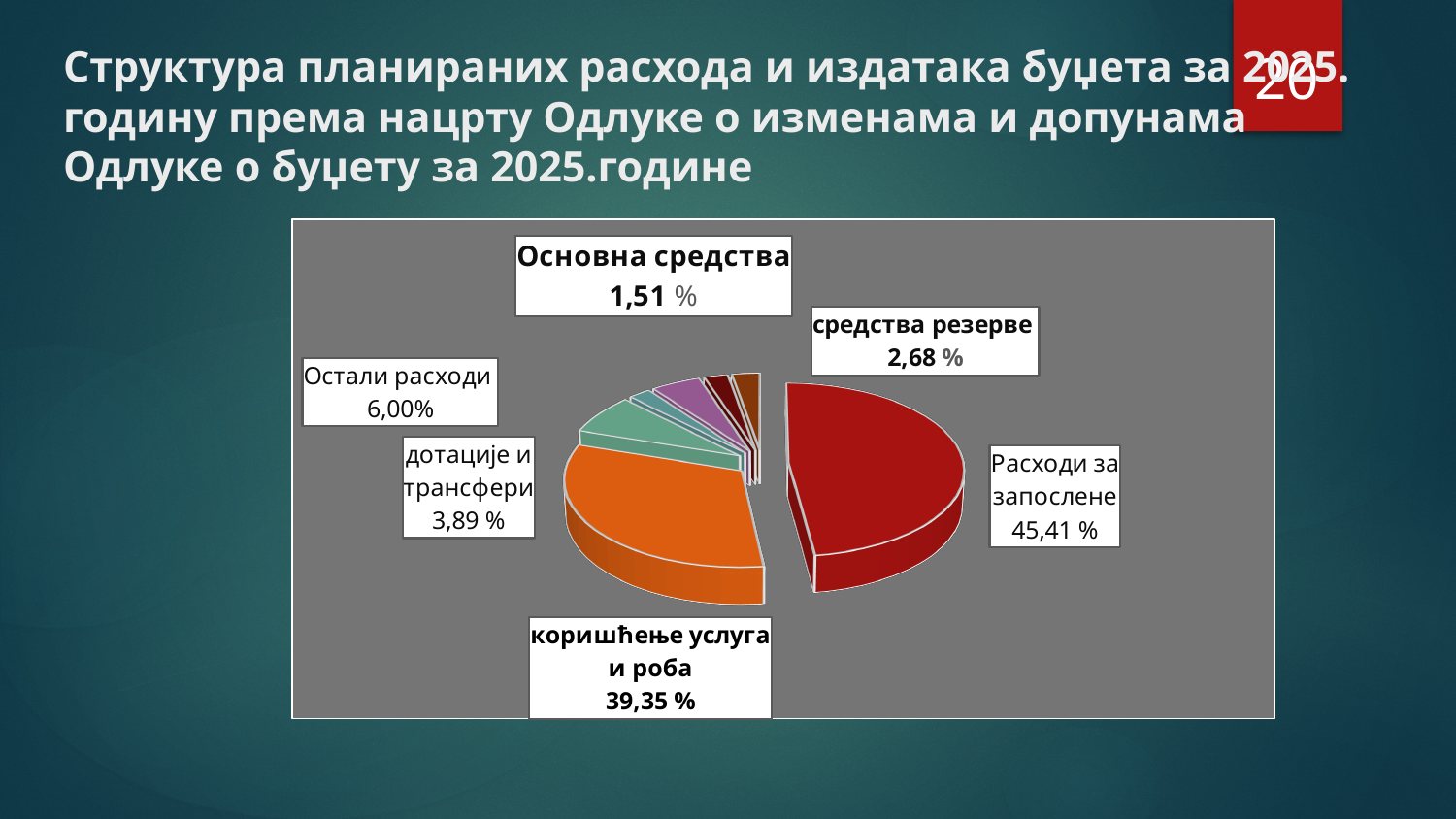
What value is shown for дотације и трансфери? 3,89 % What value is shown for Основна средства? 1,51 % What value is shown for средства резерве? 2,68 % What value is shown for Остали расходи? 6,00% Which labelled category has the largest share of the pie? Расходи за запослене What value is shown for коришћење услуга и роба? 39,35 % Which is larger: the share for Остали расходи or the share for дотације и трансфери? Остали расходи How many slices of the pie have a data label with a value? 6 What is the difference between the shares of Расходи за запослене and коришћење услуга и роба? 6,06 % Which labelled category has the smallest share of the pie? Основна средства What kind of chart is shown on the slide? pie chart What share of the pie is labelled for Расходи за запослене? 45,41 %